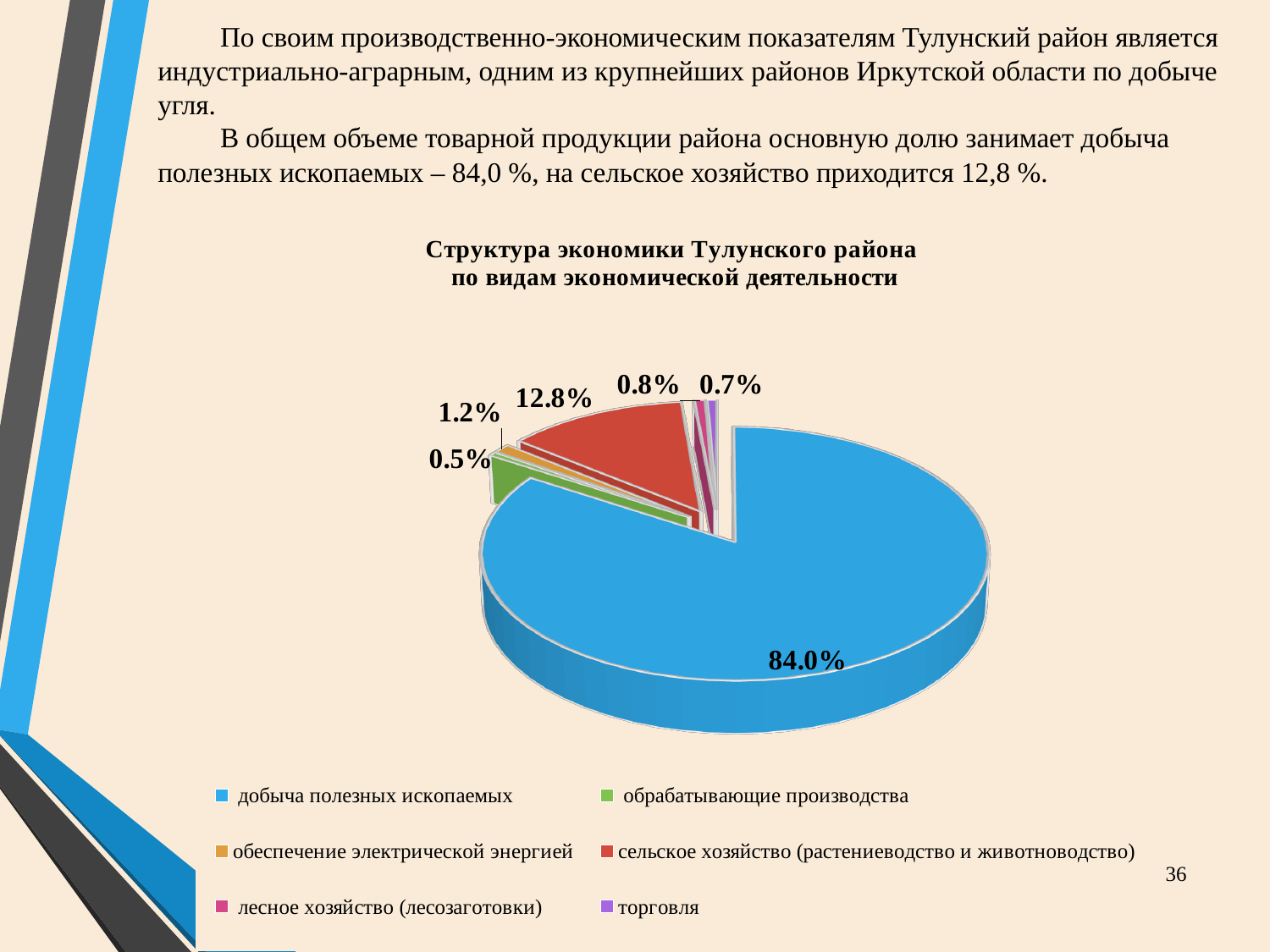
What share of the Tulun district economy does добыча полезных ископаемых account for? 84.0% Which category has the largest slice of the pie chart? добыча полезных ископаемых What is the smallest percentage labelled on the pie chart? 0.5% How many categories does the legend of the pie chart list? 6 Which is larger: the share of добыча полезных ископаемых or the share of сельское хозяйство? добыча полезных ископаемых What share does сельское хозяйство (растениеводство и животноводство) have in the pie chart? 12.8% What share does лесное хозяйство (лесозаготовки) have in the pie chart? 0.8% What is the title of the pie chart? Структура экономики Тулунского района по видам экономической деятельности Is the share of добыча полезных ископаемых greater or less than 50%? greater By how many percentage points does добыча полезных ископаемых exceed сельское хозяйство? 71.2 What kind of chart is shown on the slide? pie chart What colour is the slice for добыча полезных ископаемых? blue